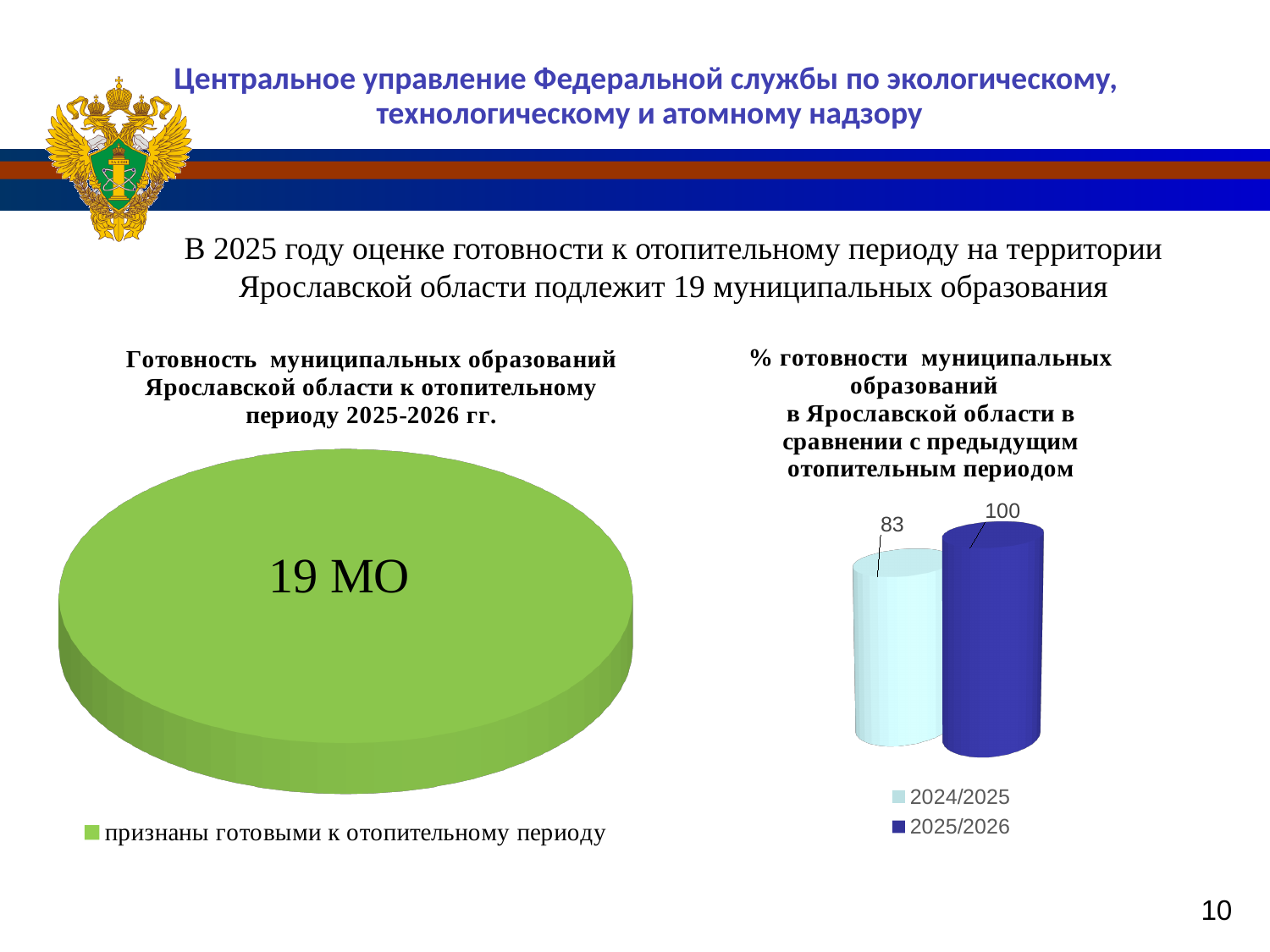
What kind of chart is the right chart on the slide? bar chart On the right chart, do the values rise or fall from 2024/2025 to 2025/2026? rise On the right chart, which period has the lowest value? 2024/2025 How many slices does the left pie chart have? 1 What is the legend entry of the left pie chart? признаны готовыми к отопительному периоду On the right chart, which period has the higher value, 2024/2025 or 2025/2026? 2025/2026 On the right chart, what is the difference between the 2025/2026 value and the 2024/2025 value? 17 What kind of chart is the left chart (Готовность муниципальных образований Ярославской области)? pie chart On the right chart (% готовности муниципальных образований), what is the value for 2024/2025? 83 What label is printed on the left pie chart? 19 МО On the right chart (% готовности муниципальных образований), what is the value for 2025/2026? 100 How many series does the legend of the right chart list? 2